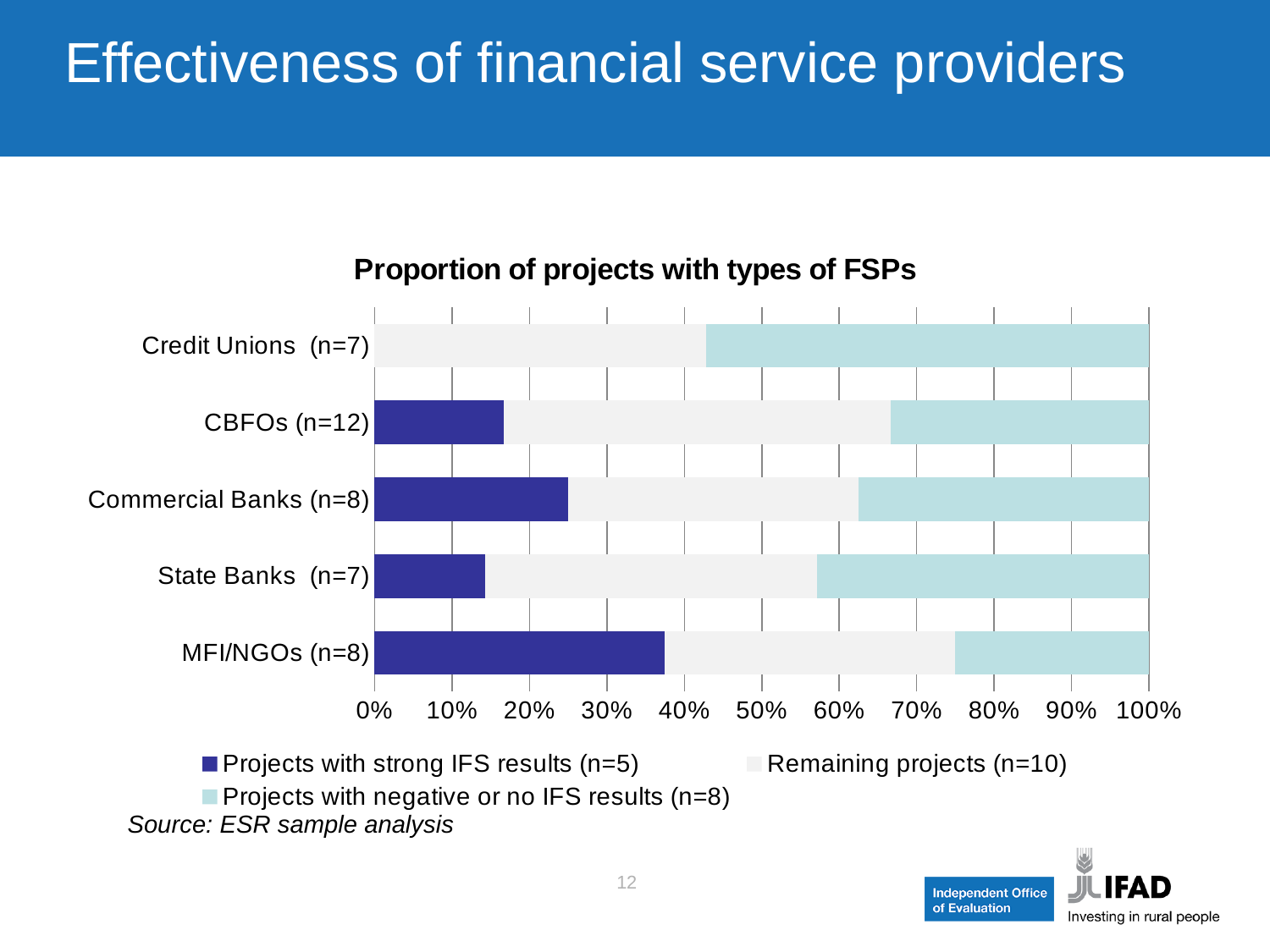
Is the share of projects with strong IFS results for CBFOs (n=12) greater or less than 20%? less How many series does the legend list? 3 Is the share of projects with strong IFS results for MFI/NGOs (n=8) greater or less than 30%? greater How many types of FSPs (categories) are shown on the chart? 5 What kind of chart is shown on the slide? stacked bar chart Which has a larger share of projects with strong IFS results, Commercial Banks (n=8) or State Banks (n=7)? Commercial Banks (n=8) Which FSP type has the smallest share of projects with strong IFS results? Credit Unions (n=7) Is the share of projects with negative or no IFS results for Credit Unions (n=7) greater or less than 50%? greater Which FSP type has the largest share of projects with strong IFS results? MFI/NGOs (n=8) What is the total of each stacked bar on the chart? 100% Which FSP type has the largest share of projects with negative or no IFS results? Credit Unions (n=7) What is the title of the chart? Proportion of projects with types of FSPs